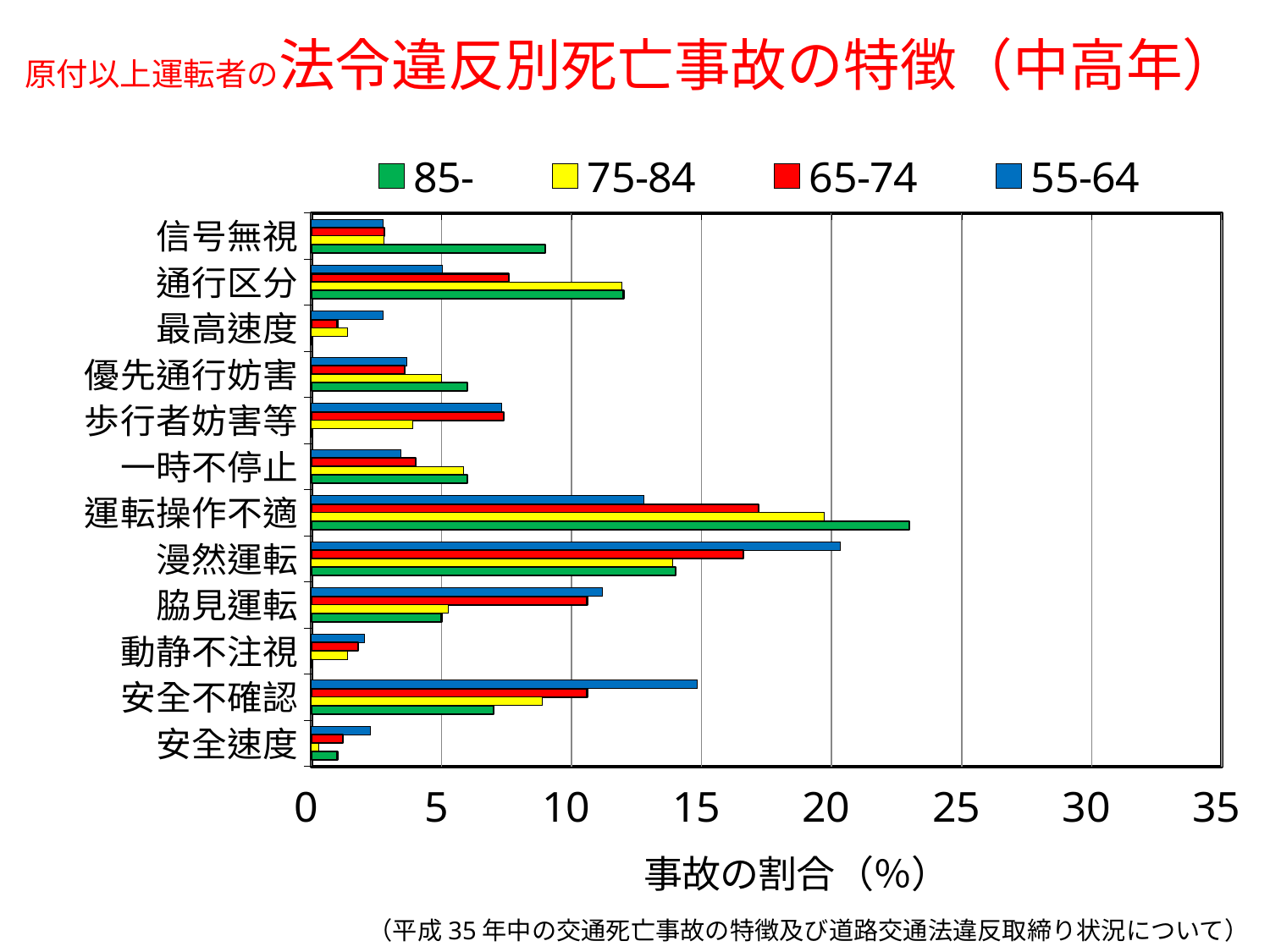
What is the title of the horizontal axis? 事故の割合（%） Is the value for 通行区分 in the 75-84 series greater or less than 10? greater Which age group is shown in green in the legend? 85- What kind of chart is shown on the slide? bar chart Is the value for 最高速度 in the 55-64 series greater or less than 5? less For 安全不確認, which is larger: the 55-64 value or the 85- value? 55-64 How many series does the legend list? 4 Is the value for 安全不確認 in the 55-64 series greater or less than 10? greater Which category has the highest value in the 55-64 series? 漫然運転 Which category has the highest value in the 85- series? 運転操作不適 How many violation categories are listed on the vertical axis of the chart? 12